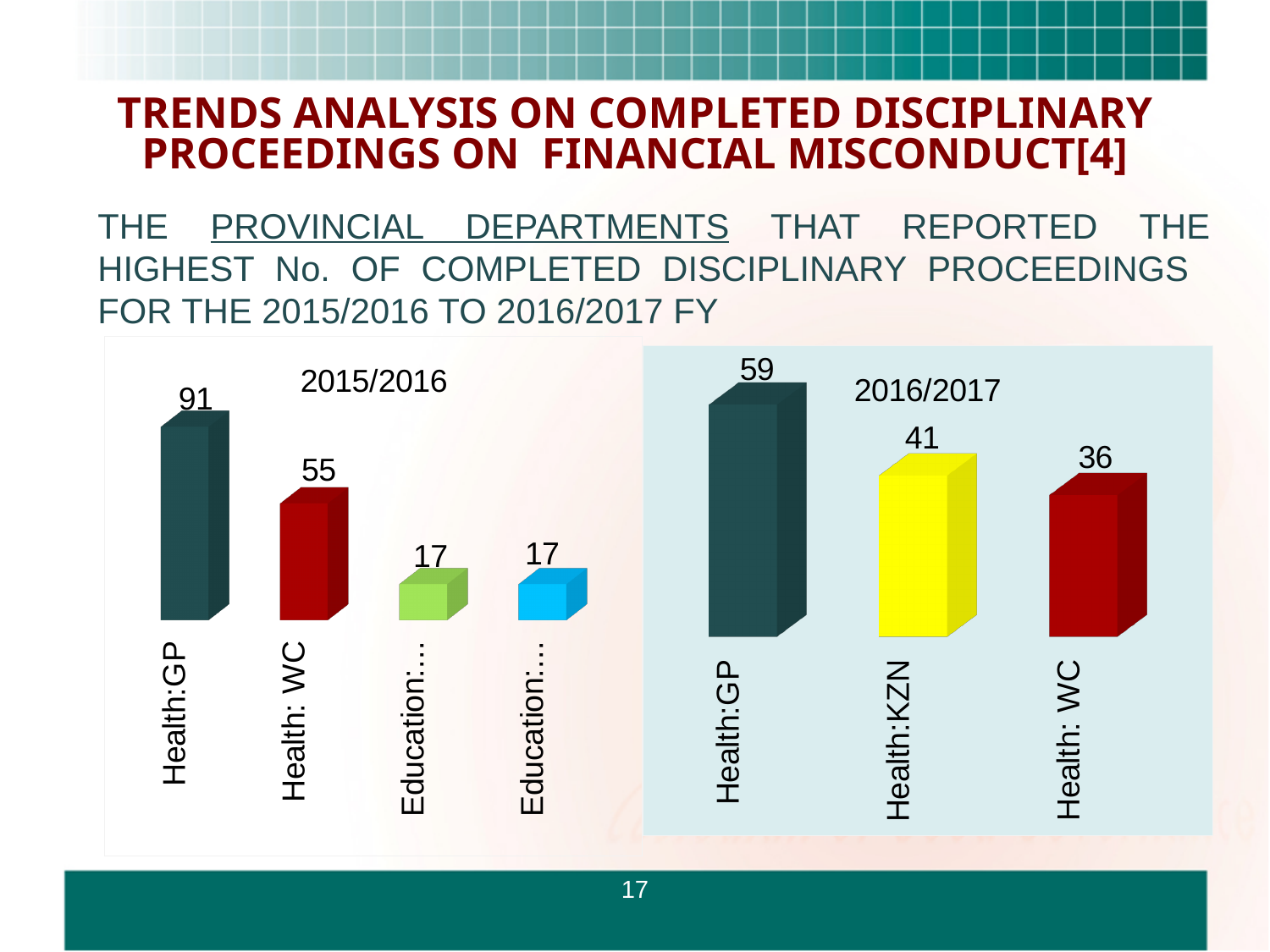
In the 2016/2017 chart, what is the value for Health:KZN? 41 What kind of chart is the 2015/2016 chart? Bar chart How many categories are shown in the 2016/2017 chart? 3 In the 2015/2016 chart, what is the difference between the values for Health:GP and Health: WC? 36 In the 2015/2016 chart, which category has the highest value? Health:GP In the 2015/2016 chart, what is the value for Health: WC? 55 In the 2016/2017 chart, what is the value for Health: WC? 36 In the 2016/2017 chart, what is the difference between the values for Health:GP and Health:KZN? 18 In the 2015/2016 chart, what is the value for Health:GP? 91 In the 2016/2017 chart, which category has the lowest value? Health: WC In the 2016/2017 chart, which category has the highest value? Health:GP Which is larger: the value for Health:GP in the 2015/2016 chart or the value for Health:GP in the 2016/2017 chart? 2015/2016